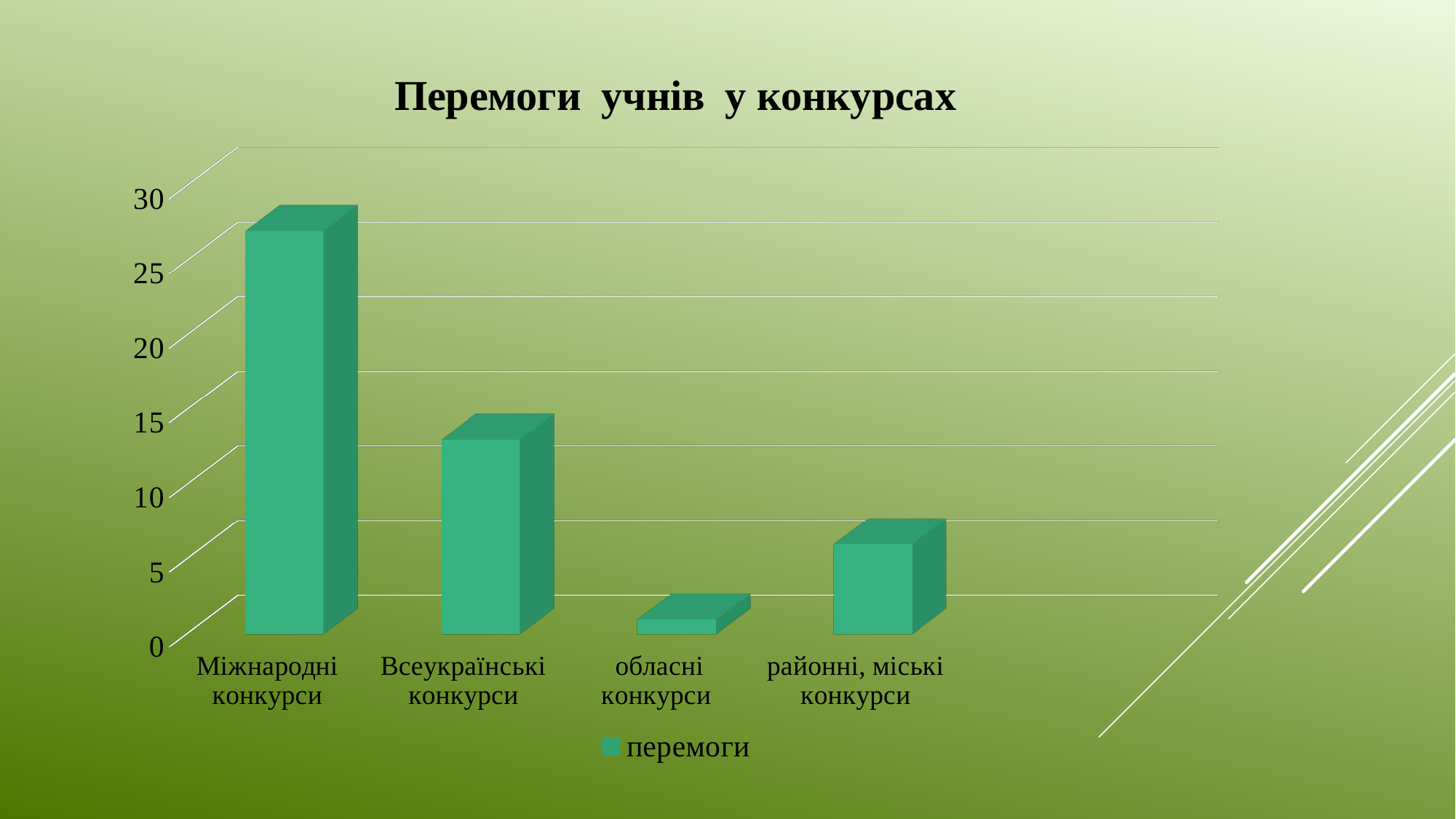
Is the value for Міжнародні конкурси greater or less than 25? greater Is the value for обласні конкурси greater or less than 5? less Is the value for районні, міські конкурси greater or less than 10? less Which is larger, the value for Всеукраїнські конкурси or the value for районні, міські конкурси? Всеукраїнські конкурси Which category has the lowest value? обласні конкурси What is the name of the series shown in the legend? перемоги How many categories are shown on the x axis of the chart? 4 How many series does the legend list? 1 What kind of chart is shown on the slide? bar chart What is the title of the chart? Перемоги учнів у конкурсах Which category has the highest value? Міжнародні конкурси